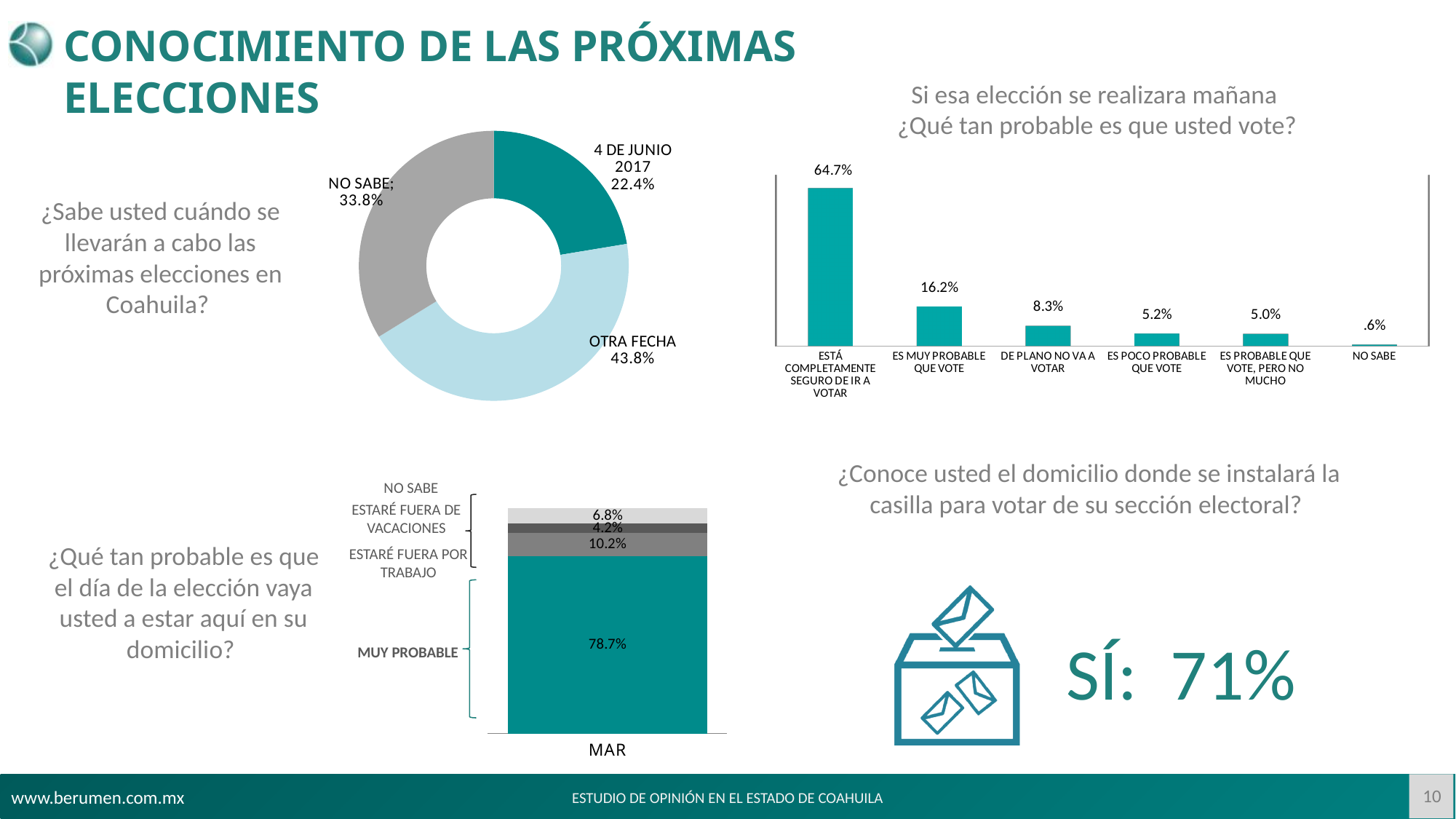
In the donut chart about when the next elections will be held, which category has the largest share? OTRA FECHA In the bar chart about how likely the respondent is to vote, what is the difference between ES MUY PROBABLE QUE VOTE and DE PLANO NO VA A VOTAR? 7.9% What kind of chart is used for the question about being at home on election day (MAR)? Stacked bar chart In the donut chart about when the next elections will be held, how many categories are shown? 3 In the bar chart about how likely the respondent is to vote, which category has the lowest value? NO SABE In the bar chart about how likely the respondent is to vote, how many categories are shown? 6 In the stacked bar chart about being at home on election day, what is the value for MUY PROBABLE? 78.7% In the bar chart about how likely the respondent is to vote, which is larger: ES MUY PROBABLE QUE VOTE or DE PLANO NO VA A VOTAR? ES MUY PROBABLE QUE VOTE In the donut chart about when the next elections will be held, what is the difference between NO SABE and 4 DE JUNIO 2017? 11.4% In the donut chart about when the next elections in Coahuila will be held, what share answered OTRA FECHA? 43.8% In the donut chart about when the next elections will be held, what share answered 4 DE JUNIO 2017? 22.4% In the bar chart about how likely the respondent is to vote, what is the value for ESTÁ COMPLETAMENTE SEGURO DE IR A VOTAR? 64.7%